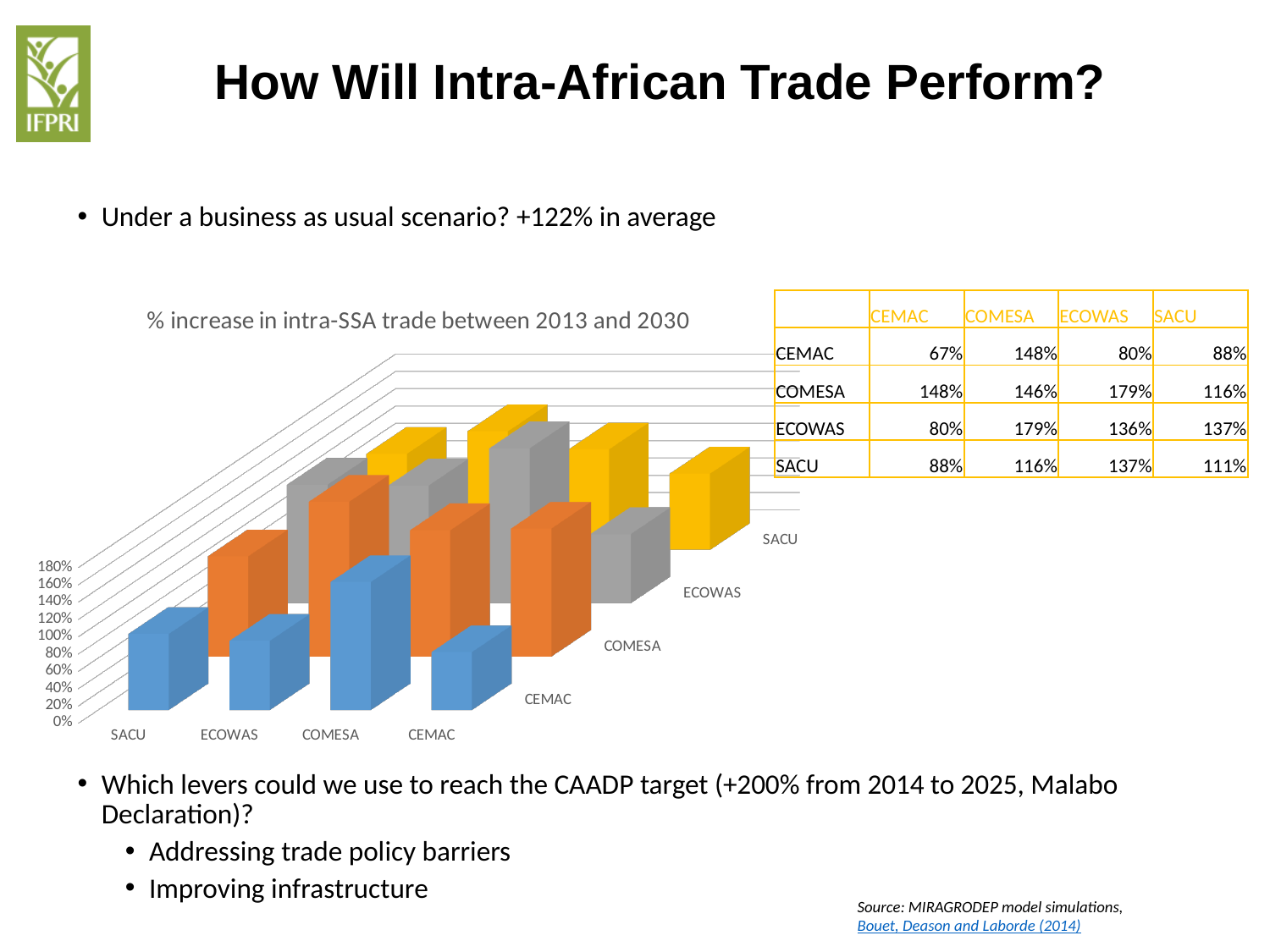
According to the table, what is the % increase in trade between SACU and SACU? 111% Which pair of regions has the highest % increase in intra-SSA trade? COMESA and ECOWAS How many series (depth-axis groups) are plotted in the chart? 4 What is the title of the chart on the slide? % increase in intra-SSA trade between 2013 and 2030 Which is larger: the COMESA–COMESA value or the SACU–SACU value? COMESA–COMESA What kind of chart is shown on the slide? bar chart What is the difference between the ECOWAS–SACU value and the CEMAC–SACU value? 49 percentage points How many categories are shown along the x axis of the chart? 4 Which pair of regions has the lowest % increase in intra-SSA trade? CEMAC and CEMAC Is the value for the CEMAC–CEMAC bar greater or less than 100%? less According to the table, what is the % increase in trade between CEMAC and CEMAC? 67% According to the table, what is the % increase in trade between COMESA and ECOWAS? 179%